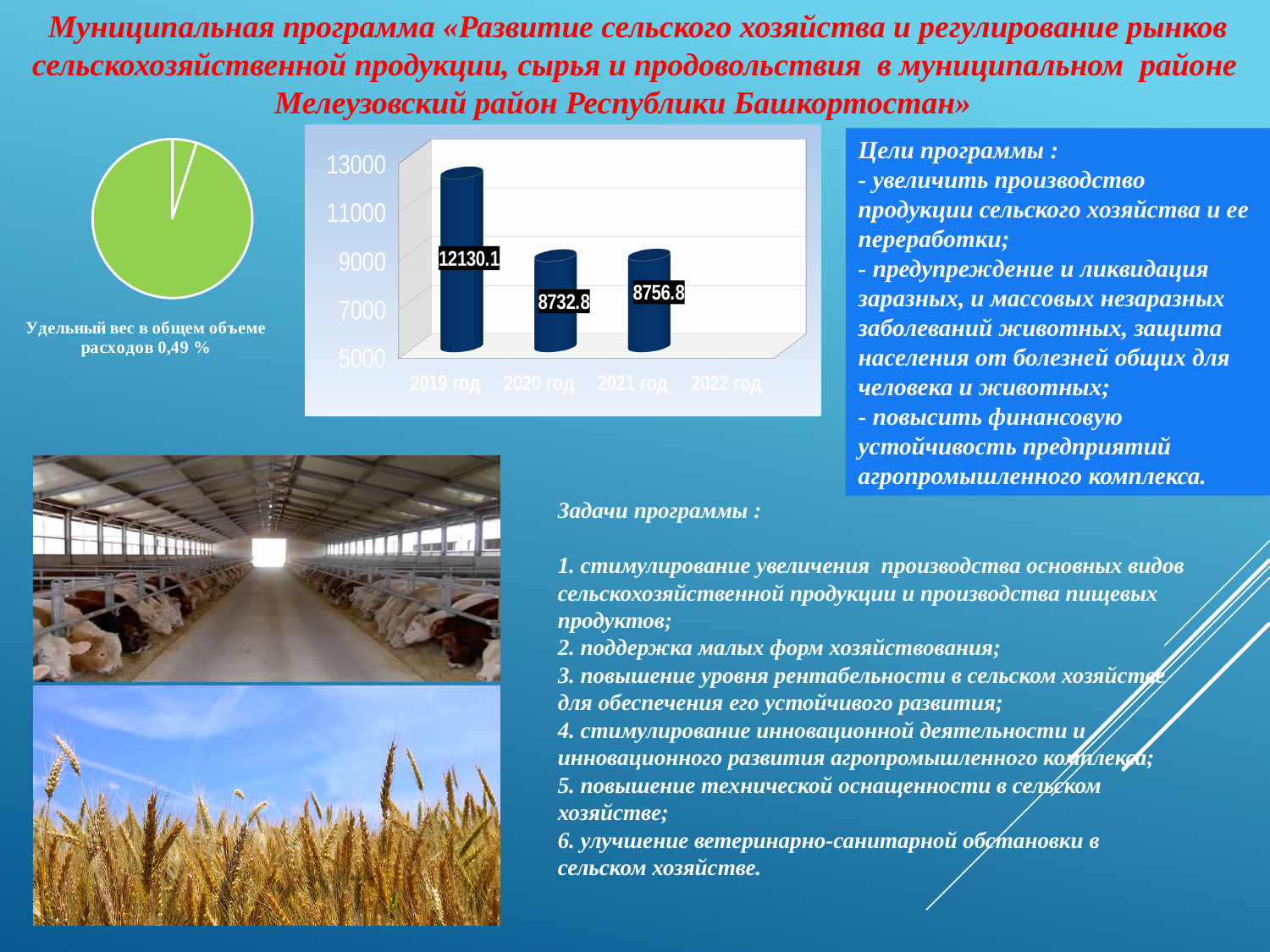
How many bars are plotted on the bar chart? 3 On the bar chart, what is the difference between the values for 2019 год and 2020 год? 3397.3 On the bar chart, what is the value for 2020 год? 8732.8 On the bar chart, is the value for 2019 год greater or less than 11000? greater On the bar chart, which year has the lowest plotted value? 2020 год What kind of chart is the green chart on the left of the slide? pie chart On the bar chart, which year has the highest value? 2019 год On the bar chart, which is larger, the value for 2020 год or 2021 год? 2021 год On the bar chart, what is the value for 2019 год? 12130.1 On the bar chart, what is the value for 2021 год? 8756.8 What kind of chart is the chart in the top centre of the slide? bar chart On the bar chart, what is the difference between the values for 2021 год and 2020 год? 24.0